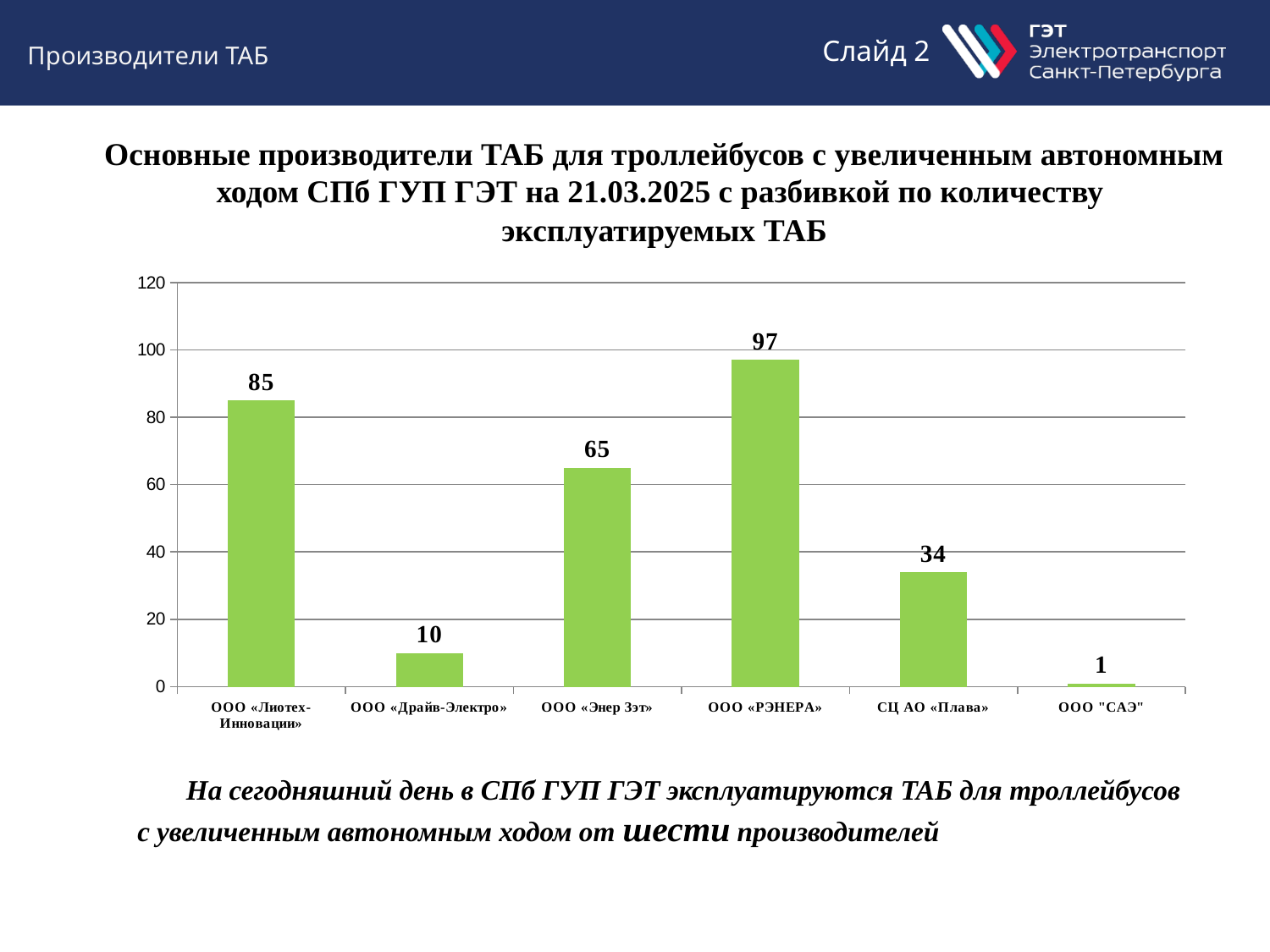
What is the maximum value shown on the vertical axis? 120 Which manufacturer has the lowest value? ООО "САЭ" What kind of chart is shown on the slide? bar chart What is the difference between the values for ООО «РЭНЕРА» and СЦ АО «Плава»? 63 Which is larger, the value for ООО «Лиотех-Инновации» or the value for ООО «РЭНЕРА»? ООО «РЭНЕРА» Which manufacturer has the highest value? ООО «РЭНЕРА» What is the value for ООО «РЭНЕРА»? 97 What is the value for ООО «Драйв-Электро»? 10 What is the value for СЦ АО «Плава»? 34 Is the value for ООО «Энер Зэт» greater or less than 60? greater What is the difference between the values for ООО «Лиотех-Инновации» and ООО «Энер Зэт»? 20 How many manufacturers are shown on the chart? 6